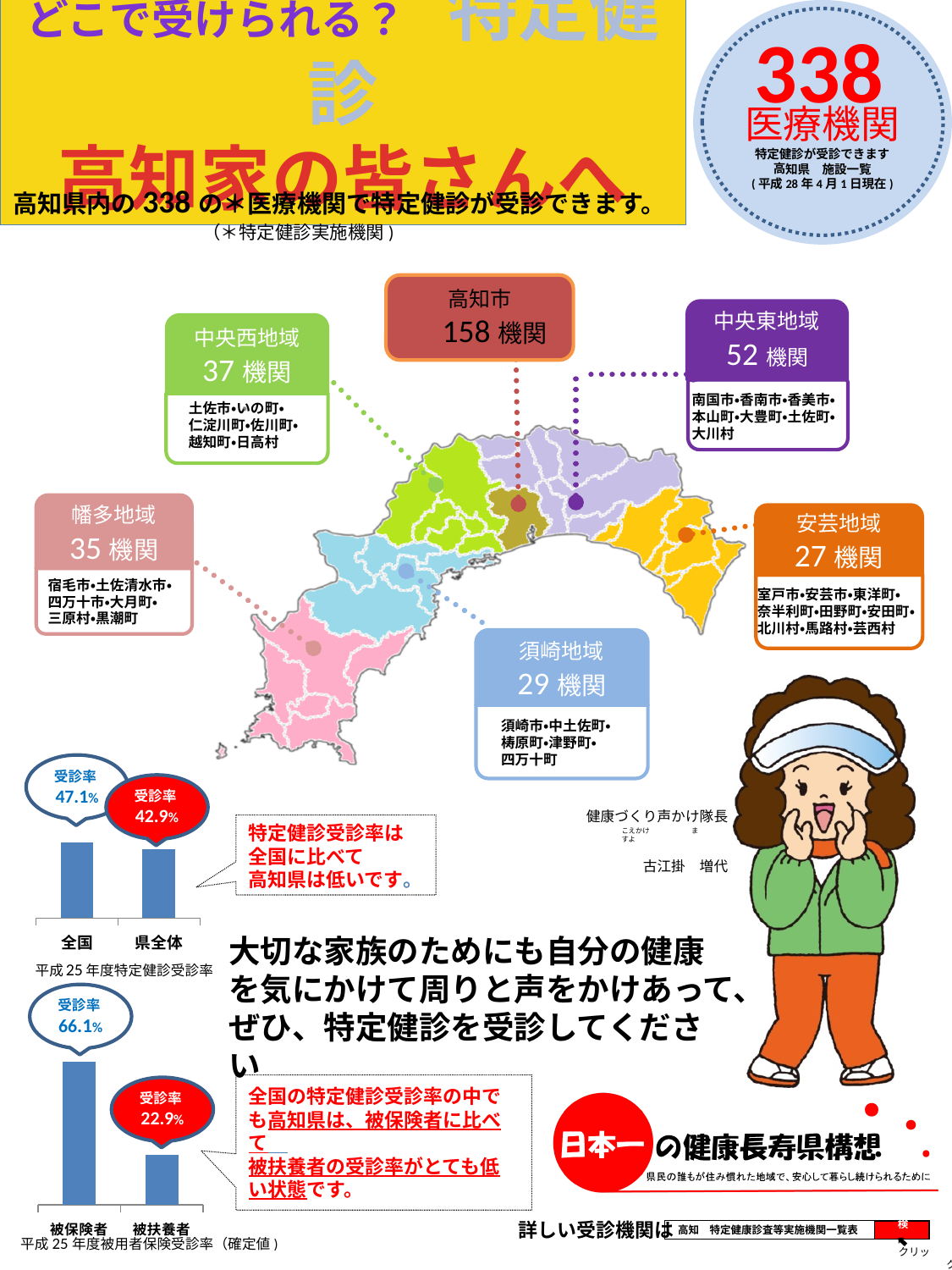
In the top bar chart (平成25年度特定健診受診率), which category has the higher 受診率, 全国 or 県全体? 全国 In the top bar chart (平成25年度特定健診受診率), how many categories are shown? 2 In the top bar chart (平成25年度特定健診受診率), what is the difference between the 全国 and 県全体 rates? 4.2% In the bottom bar chart (平成25年度被用者保険受診率), how many categories are shown? 2 In the top bar chart (平成25年度特定健診受診率), what is the 受診率 for 県全体? 42.9% In the bottom bar chart (平成25年度被用者保険受診率), what is the difference between the 被保険者 and 被扶養者 rates? 43.2% In the bottom bar chart (平成25年度被用者保険受診率), what is the 受診率 for 被扶養者? 22.9% In the bottom bar chart (平成25年度被用者保険受診率), what is the 受診率 for 被保険者? 66.1% In the top bar chart (平成25年度特定健診受診率), what is the 受診率 for 全国? 47.1% In the bottom bar chart (平成25年度被用者保険受診率), which category has the lowest 受診率? 被扶養者 What kind of chart is the top chart labelled 平成25年度特定健診受診率? bar chart What colour are the bars in the two bar charts on the slide? blue